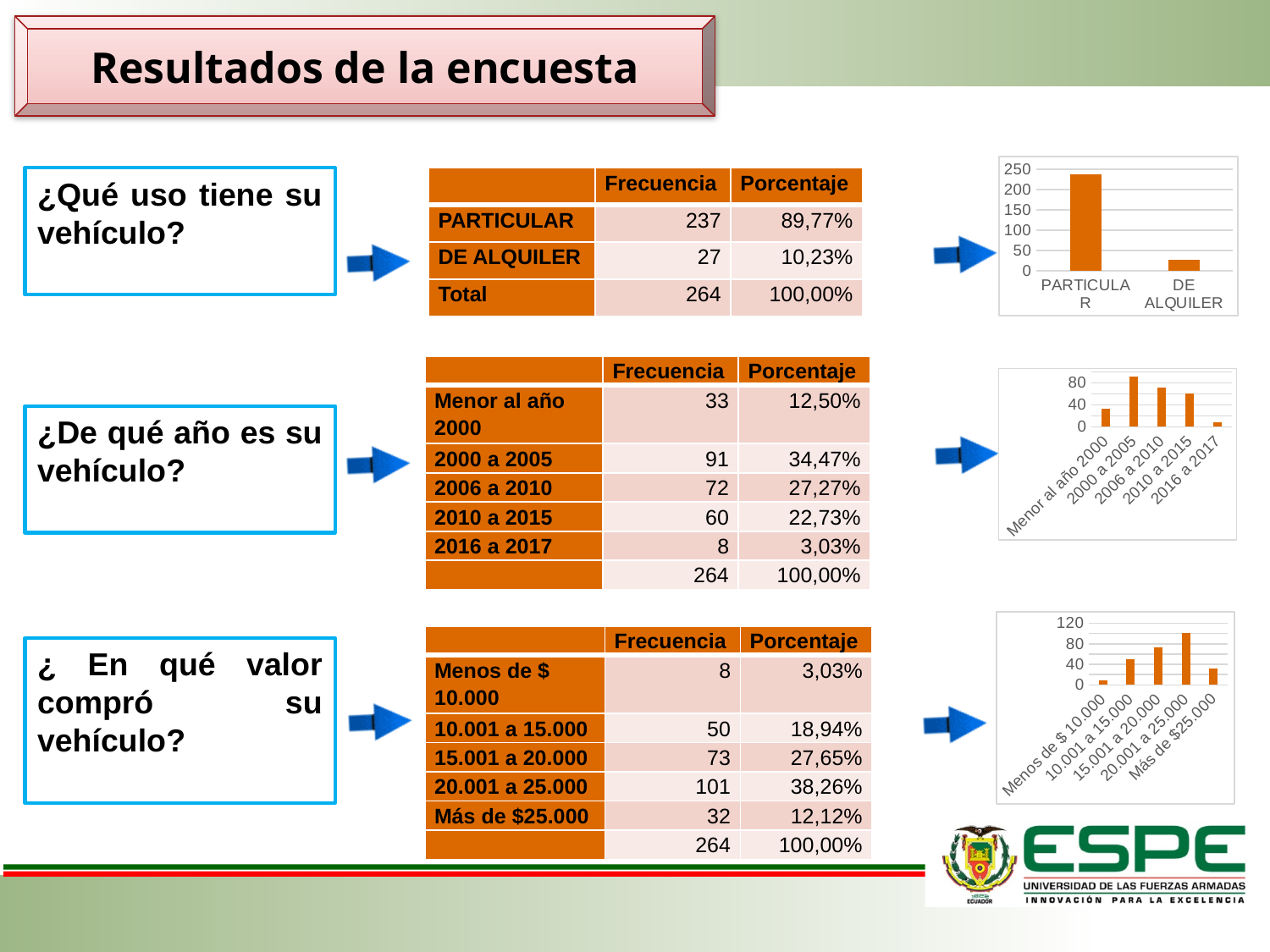
In the top chart (¿Qué uso tiene su vehículo?), which category has the highest bar? PARTICULAR How many categories are shown in the middle chart (¿De qué año es su vehículo?)? 5 In the top chart (¿Qué uso tiene su vehículo?), is the value for DE ALQUILER greater or less than 50? less In the middle chart (¿De qué año es su vehículo?), which category has the highest bar? 2000 a 2005 In the bottom chart (¿En qué valor compró su vehículo?), which category has the highest bar? 20.001 a 25.000 In the middle chart (¿De qué año es su vehículo?), which is larger: the bar for 2006 a 2010 or the bar for 2010 a 2015? 2006 a 2010 In the middle chart (¿De qué año es su vehículo?), is the value for 2000 a 2005 greater or less than 80? greater In the middle chart (¿De qué año es su vehículo?), which category has the lowest bar? 2016 a 2017 What type of chart is used for the question ¿Qué uso tiene su vehículo? bar chart In the bottom chart (¿En qué valor compró su vehículo?), is the value for 20.001 a 25.000 greater or less than 80? greater In the bottom chart (¿En qué valor compró su vehículo?), which category has the lowest bar? Menos de $ 10.000